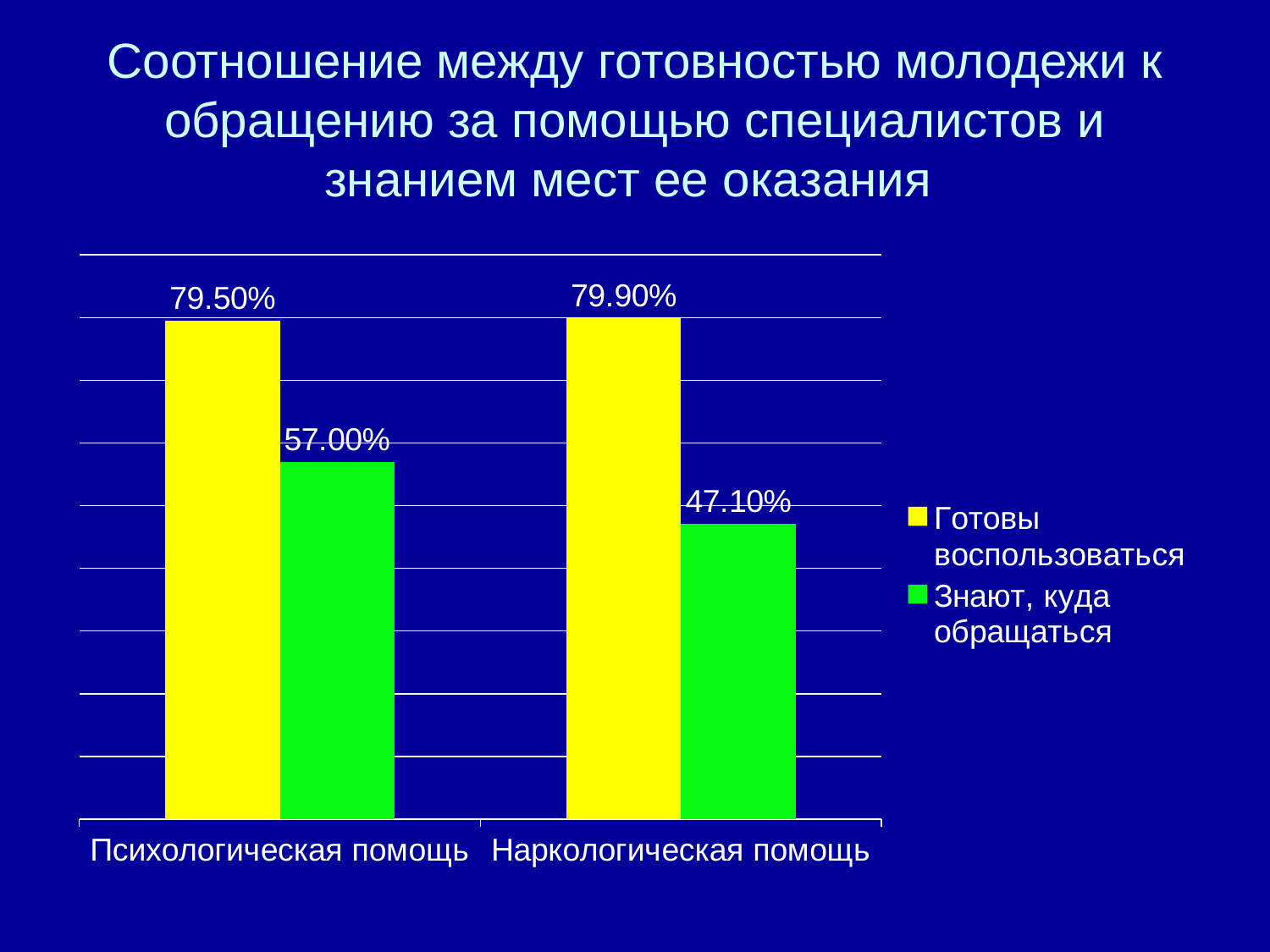
How many categories are shown on the x axis of the chart? 2 What is the value for "Знают, куда обращаться" in the "Психологическая помощь" category? 57.00% What is the difference between "Готовы воспользоваться" and "Знают, куда обращаться" in the "Наркологическая помощь" category? 32.80% What is the value for "Готовы воспользоваться" in the "Наркологическая помощь" category? 79.90% What is the value for "Знают, куда обращаться" in the "Наркологическая помощь" category? 47.10% Which category has the lowest value for "Знают, куда обращаться"? Наркологическая помощь In the "Наркологическая помощь" category, which is larger: "Готовы воспользоваться" or "Знают, куда обращаться"? Готовы воспользоваться Which category has the highest value for "Знают, куда обращаться"? Психологическая помощь What is the difference between "Готовы воспользоваться" and "Знают, куда обращаться" in the "Психологическая помощь" category? 22.50% What kind of chart is shown on the slide? Bar chart How many series does the chart legend list? 2 What is the value for "Готовы воспользоваться" in the "Психологическая помощь" category? 79.50%